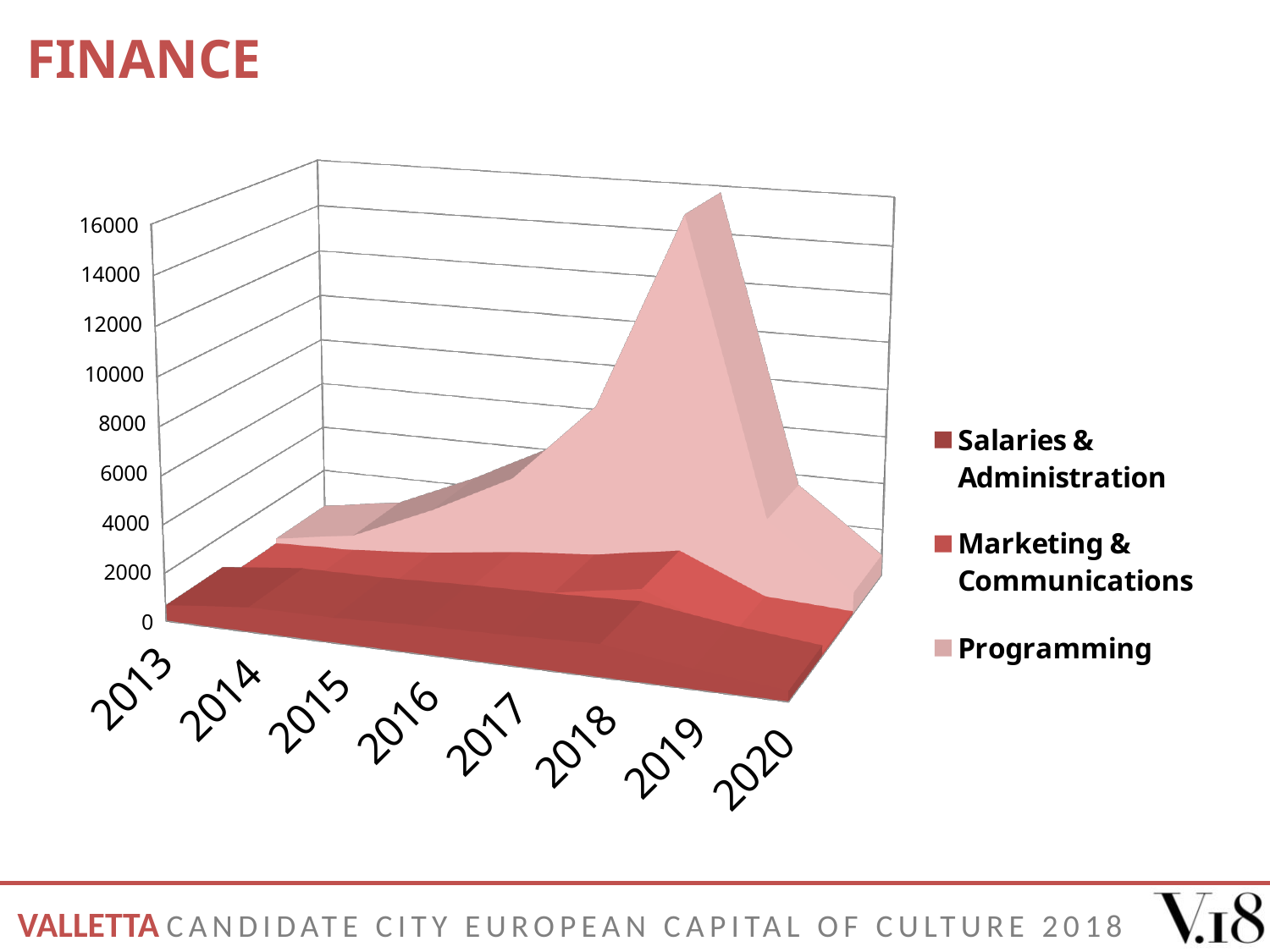
Does the Programming series rise or fall from 2019 to 2020? fall What kind of chart is shown on the slide? Area chart Does the Programming series rise or fall from 2013 to 2019? rise How many years are shown along the x axis of the chart? 8 Is the total stacked value for 2013 greater or less than 6000? less How many series does the chart's legend list? 3 What is the title of the slide containing the chart? FINANCE Is the Programming value larger in 2019 or in 2013? 2019 In which year does the Programming series reach its highest value? 2018 Which series has the largest value in 2019? Programming Which series are listed in the chart's legend? Salaries & Administration, Marketing & Communications, Programming